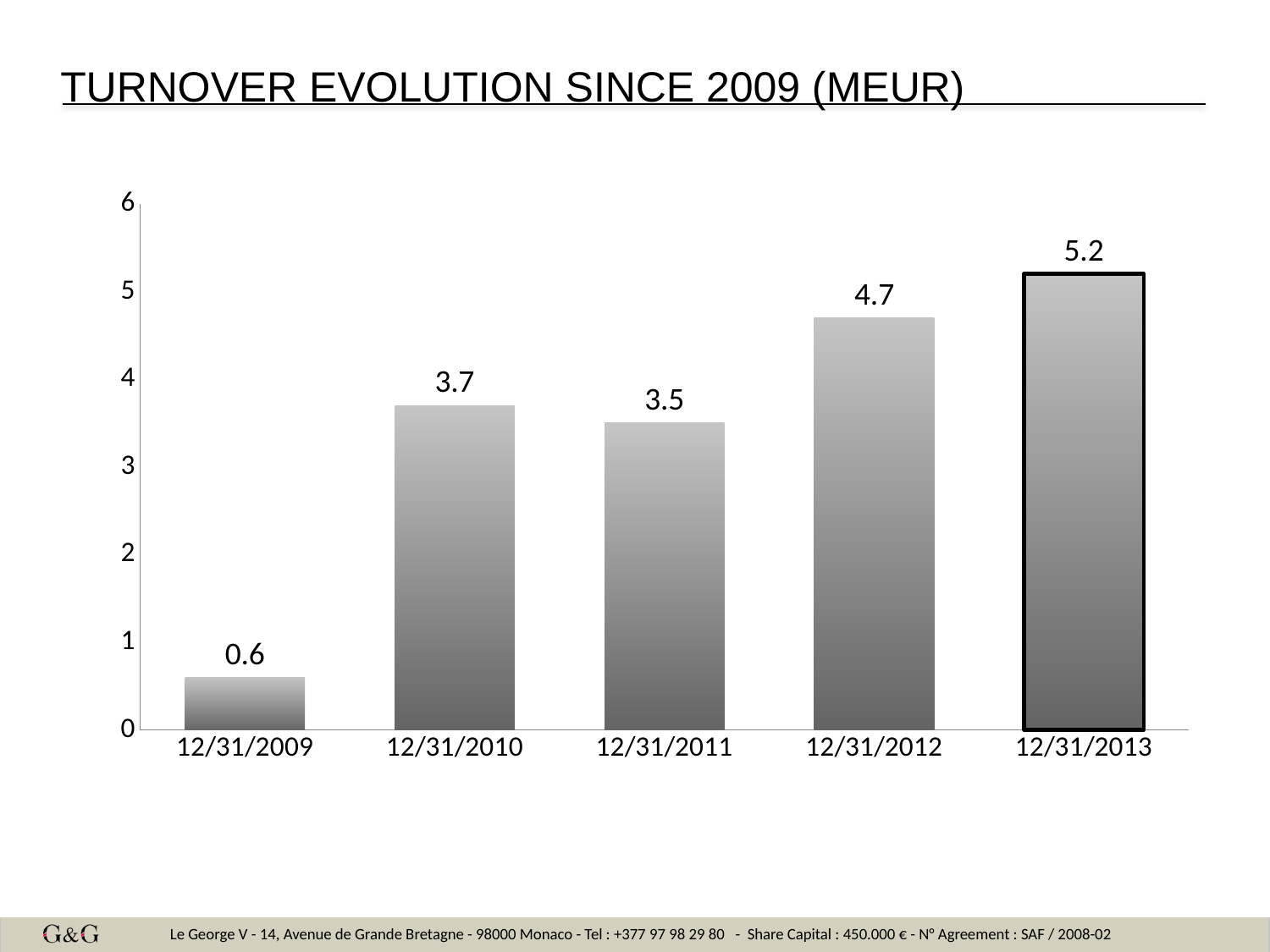
What is the turnover value for 12/31/2011? 3.5 What is the title of the chart? TURNOVER EVOLUTION SINCE 2009 (MEUR) Which date has the highest turnover? 12/31/2013 What is the difference between the turnover for 12/31/2010 and 12/31/2009? 3.1 What is the difference between the turnover for 12/31/2013 and 12/31/2012? 0.5 How many dates are shown on the x axis? 5 What is the turnover value for 12/31/2009? 0.6 Which is larger, the turnover for 12/31/2010 or 12/31/2011? 12/31/2010 What is the turnover value for 12/31/2013? 5.2 Is the turnover for 12/31/2012 greater or less than 4? greater Which date has the lowest turnover? 12/31/2009 What kind of chart is shown on the slide? bar chart